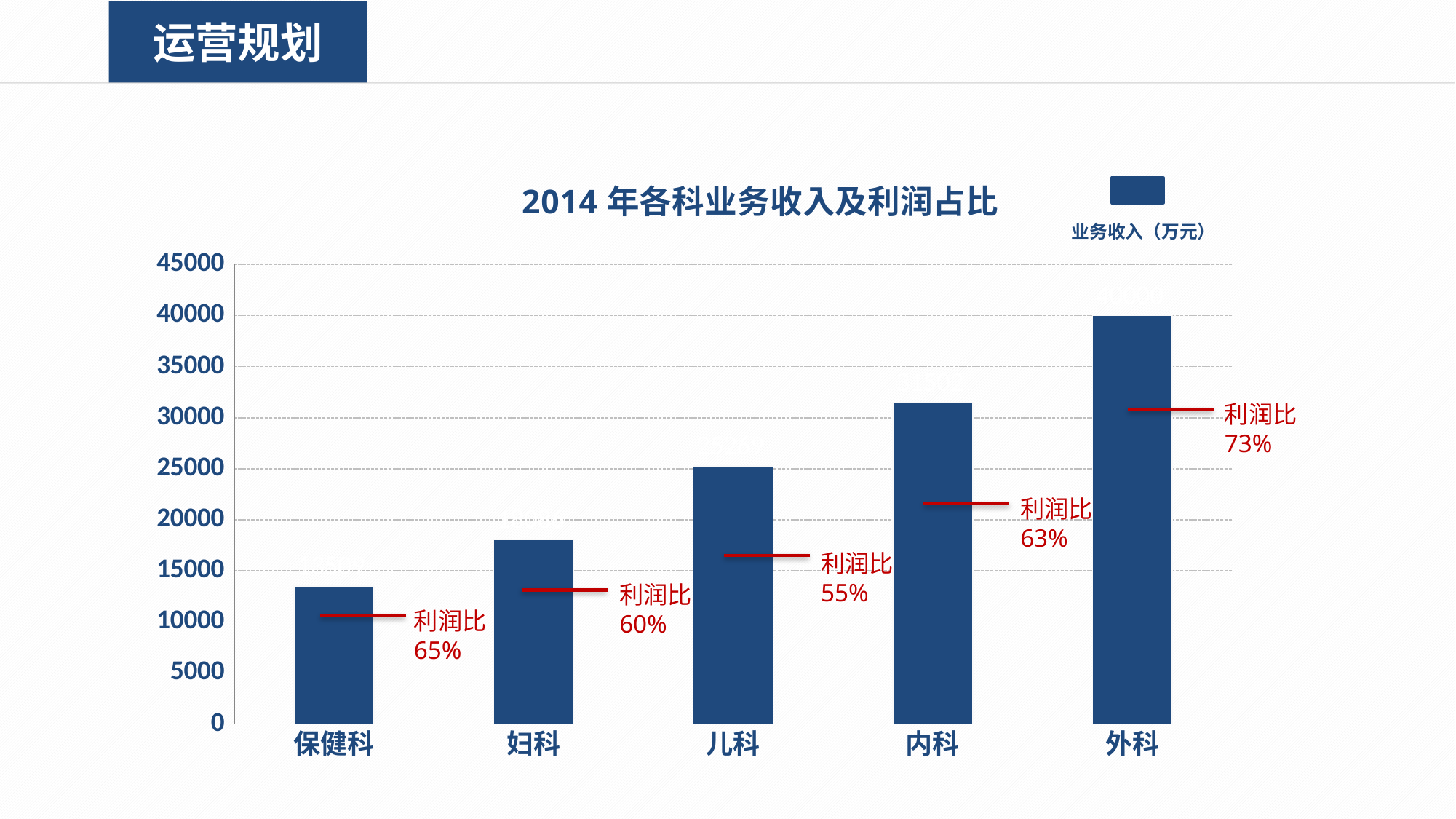
Is the 业务收入 value for 内科 greater or less than 30000? greater Do the 业务收入 bars rise or fall from left to right along the x axis? rise Which department has the highest 业务收入 bar? 外科 How many series does the legend list? 1 How many departments (categories) are shown on the x axis? 5 Which department has the lowest 业务收入 bar? 保健科 Is the 业务收入 value for 保健科 greater or less than 15000? less What kind of chart is shown on the slide? bar chart What is the 利润比 annotated for 保健科? 65% What is the title of the chart? 2014 年各科业务收入及利润占比 What is the 利润比 annotated for 外科? 73% Which department has the lowest annotated 利润比? 儿科